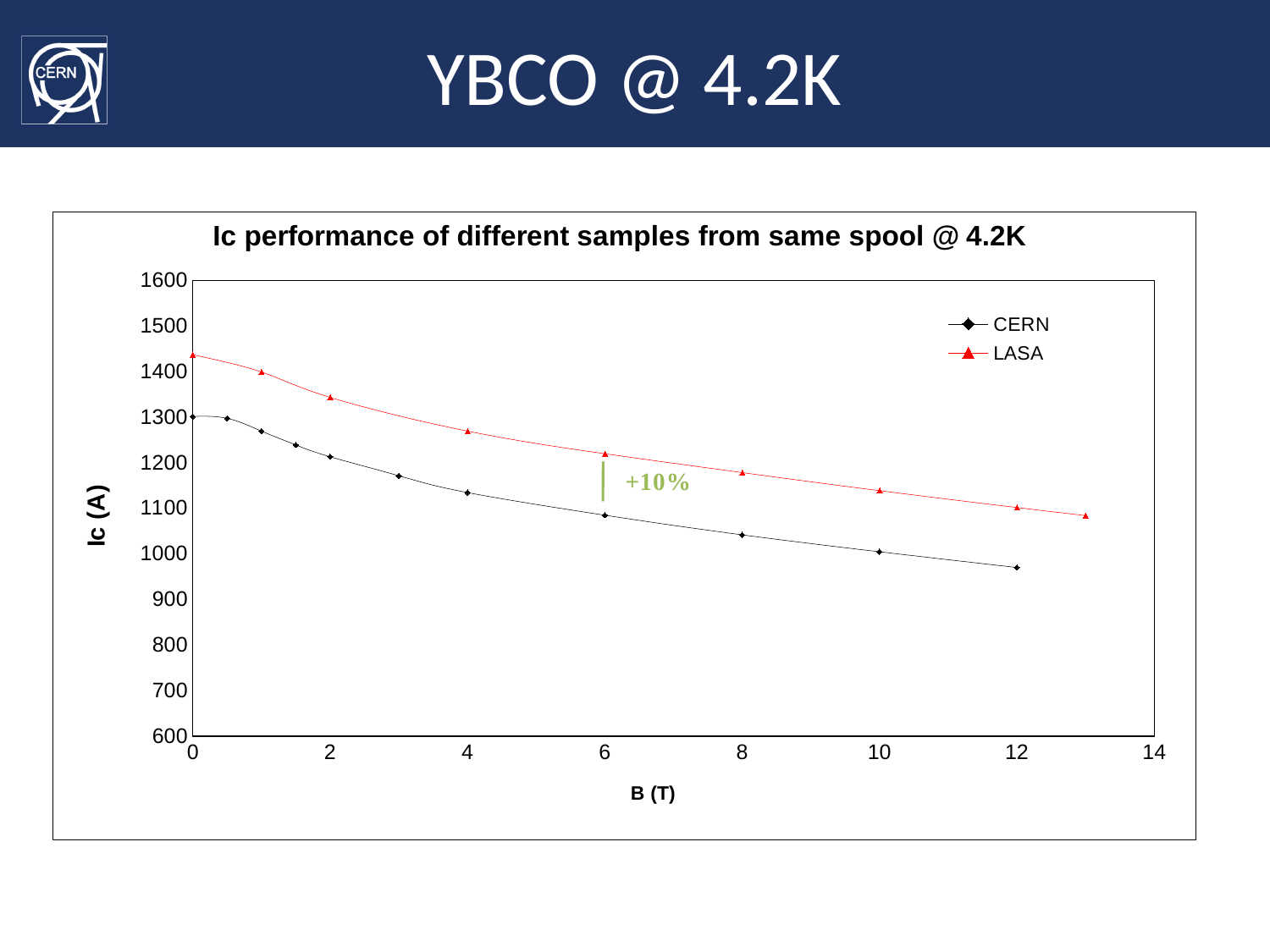
Is the LASA value at 4 T greater or less than 1200? greater What is the label of the y axis? Ic (A) What kind of chart is shown on the slide? line chart How many series does the legend list? 2 Is the CERN value at 8 T greater or less than 1100? less Is the CERN value at 12 T greater or less than 1000? less What is the title of the chart? Ic performance of different samples from same spool @ 4.2K At 6 T, which series has the higher Ic, CERN or LASA? LASA Do the Ic values for the LASA series rise or fall as B increases? fall Do the Ic values for the CERN series rise or fall as B increases? fall